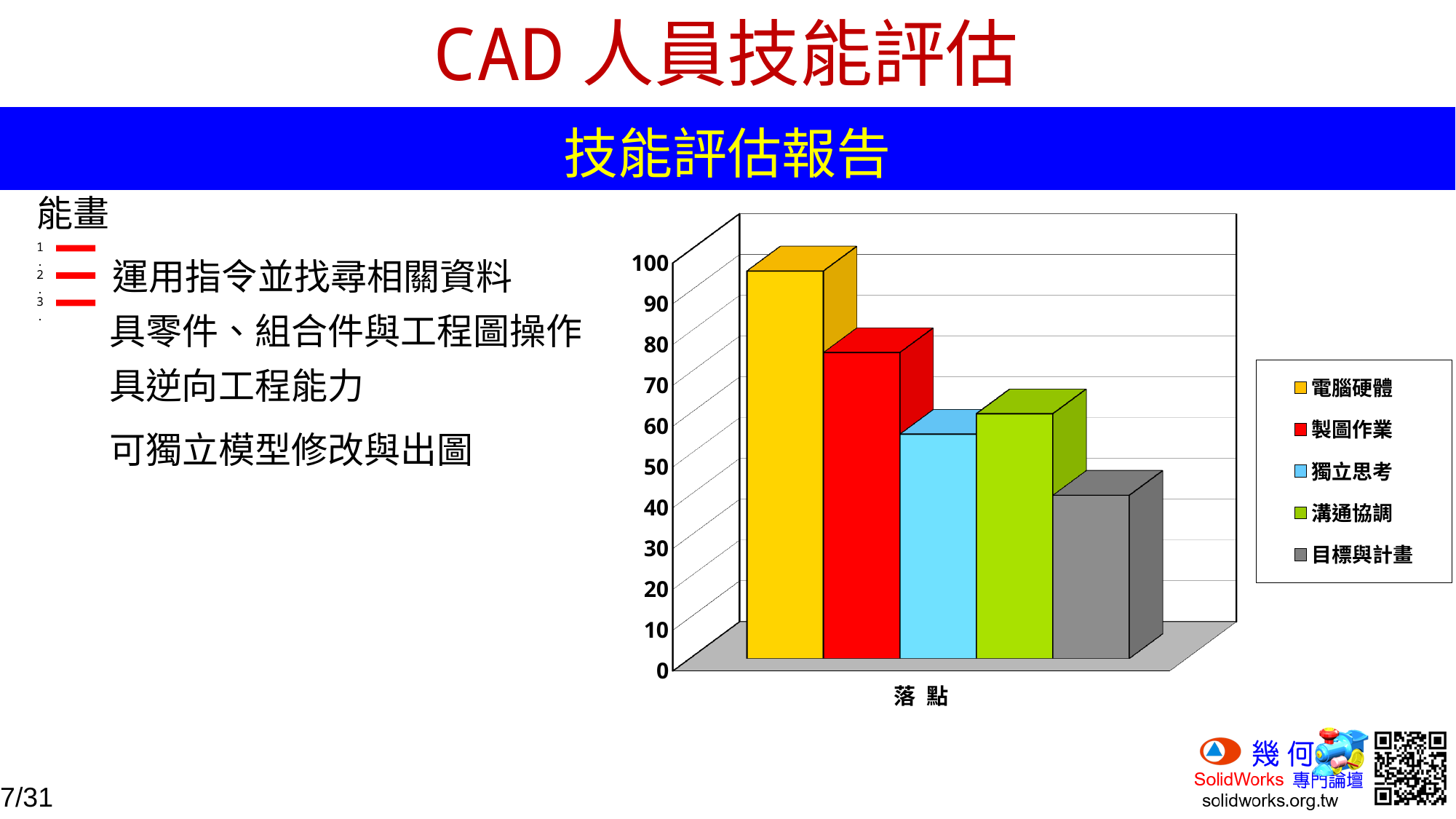
Is the value for 目標與計畫 greater or less than 50? less Which series has the lowest bar? 目標與計畫 Is the value for 電腦硬體 greater or less than 90? greater Is the value for 製圖作業 greater or less than 70? greater What is the label shown on the x axis of the chart? 落 點 Which is larger, the value for 製圖作業 or the value for 溝通協調? 製圖作業 What colour represents 製圖作業 in the legend? red How many series does the legend list? 5 What kind of chart is shown on the slide? bar chart Which series has the highest bar? 電腦硬體